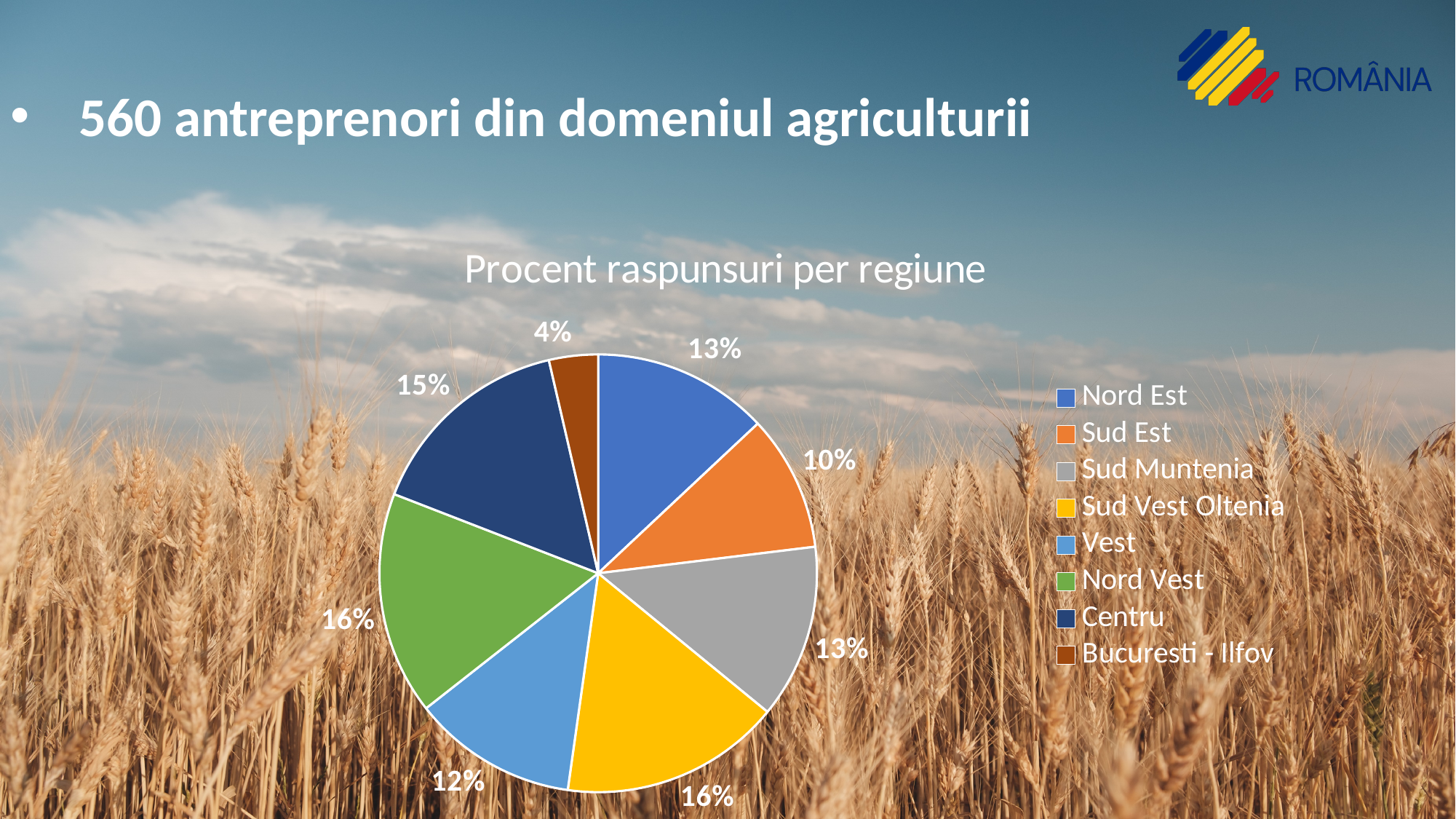
How many regions are shown in the pie chart? 8 What is the difference in percentage points between Nord Vest and Sud Est? 6% Which region has a larger share of responses, Centru or Vest? Centru What is the title of the chart? Procent raspunsuri per regiune What colour is the slice for Sud Vest Oltenia? yellow What percentage of responses came from the Vest region? 12% What percentage of responses came from the Nord Est region? 13% What type of chart is shown on the slide? pie chart What share of the pie does Bucuresti - Ilfov represent? 4% Which region has the smallest share of responses? Bucuresti - Ilfov What percentage of responses came from the Centru region? 15% What percentage of responses came from the Sud Est region? 10%